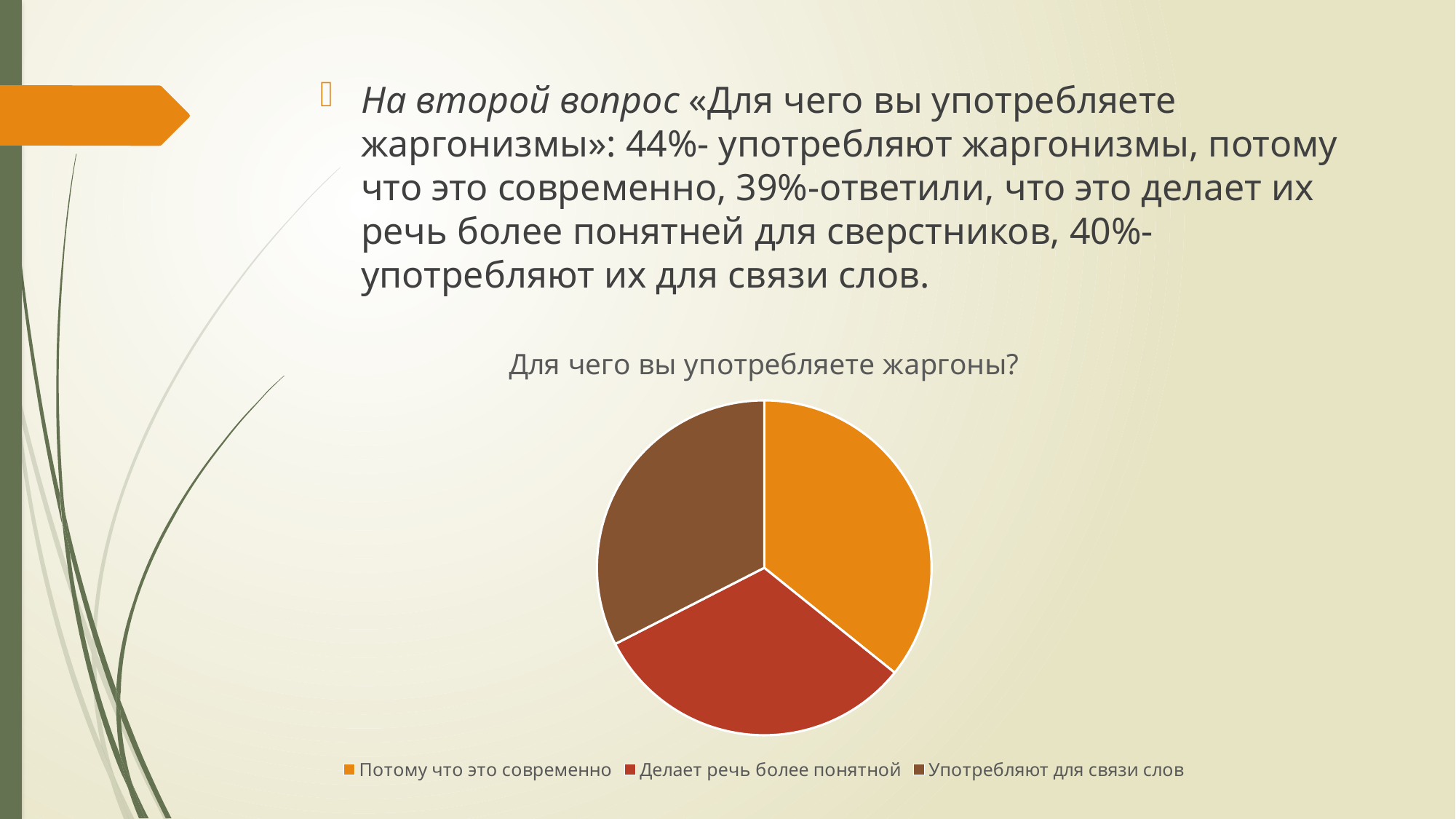
Which slice is larger: "Потому что это современно" or "Делает речь более понятной"? Потому что это современно What kind of chart is shown on the slide? pie chart What is the title of the pie chart? Для чего вы употребляете жаргоны? How many entries does the legend of the pie chart list? 3 Which legend entry is shown in orange on the pie chart? Потому что это современно How many slices does the pie chart have? 3